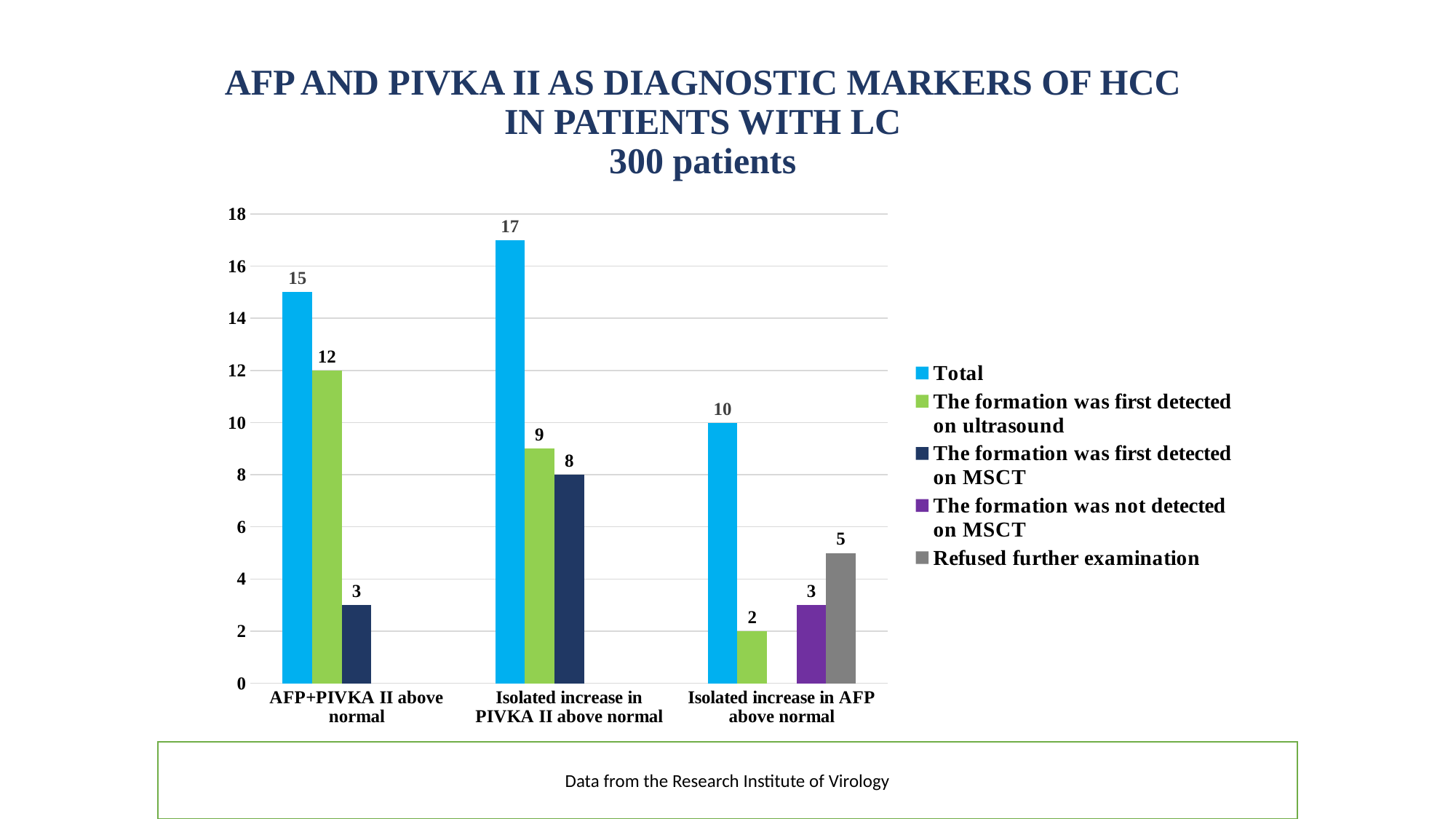
What is the value for 'The formation was not detected on MSCT' in the 'Isolated increase in AFP above normal' category? 3 Which category has the lowest Total value? Isolated increase in AFP above normal How many series does the legend list? 5 Which category has the highest Total value? Isolated increase in PIVKA II above normal Which colour represents the Total series in the legend? Light blue In the 'Isolated increase in PIVKA II above normal' category, which is larger: the value first detected on ultrasound or the value first detected on MSCT? The formation was first detected on ultrasound What is the value for 'Refused further examination' in the 'Isolated increase in AFP above normal' category? 5 What is the Total value for the 'Isolated increase in PIVKA II above normal' category? 17 What kind of chart is shown on the slide? Bar chart How many categories are shown on the x axis? 3 How many patients in the 'AFP+PIVKA II above normal' category had the formation first detected on ultrasound? 12 What is the difference between the Total and the 'first detected on ultrasound' values in the 'AFP+PIVKA II above normal' category? 3